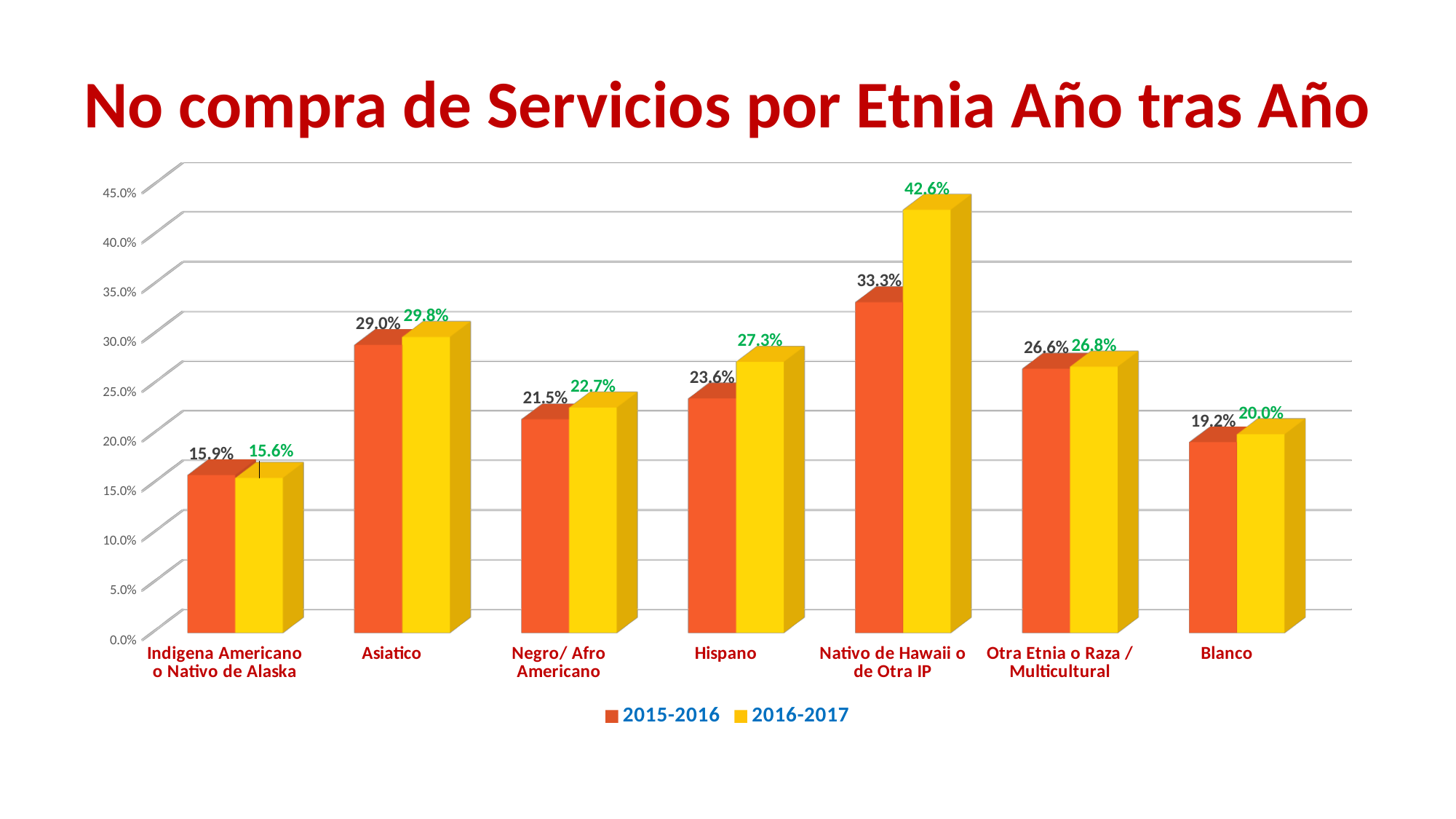
Which category has the highest 2016-2017 value? Nativo de Hawaii o de Otra IP Which is larger for Hispano: the 2015-2016 value or the 2016-2017 value? 2016-2017 How many ethnic categories are shown on the x axis? 7 How many series does the legend list? 2 Which category has the lowest 2015-2016 value? Indigena Americano o Nativo de Alaska What kind of chart is shown on the slide? bar chart What is the 2016-2017 value for Nativo de Hawaii o de Otra IP? 42.6% What is the 2015-2016 value for Asiatico? 29.0% Is the 2015-2016 value for Negro/ Afro Americano greater or less than 25.0%? less What is the 2016-2017 value for Blanco? 20.0% What is the title of the chart? No compra de Servicios por Etnia Año tras Año What is the difference between the 2016-2017 and 2015-2016 values for Nativo de Hawaii o de Otra IP? 9.3%